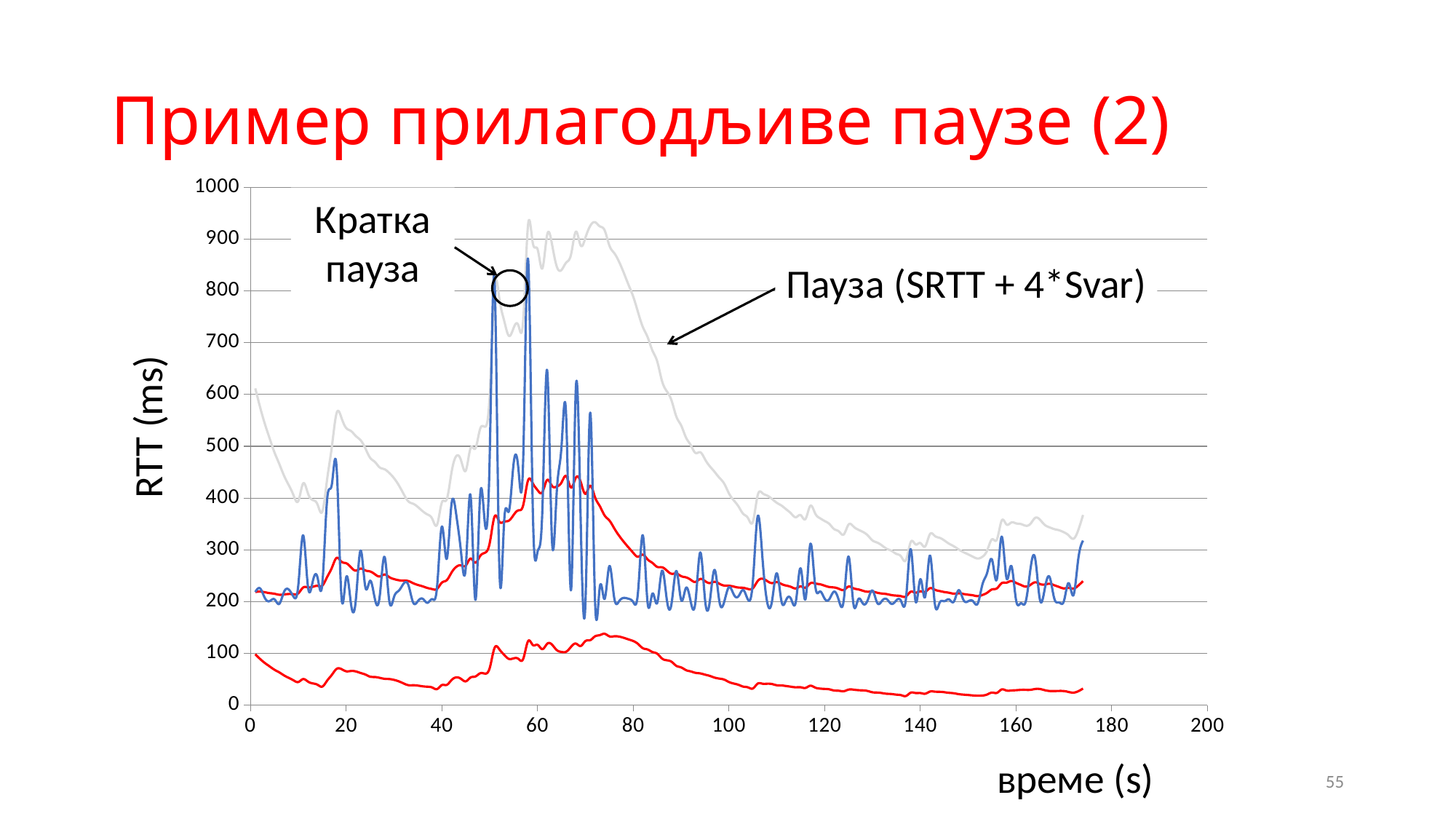
What is the label of the horizontal axis of the chart? време (s) Is the peak of the blue line near 58 s greater or less than 800? greater Is the value of the lowest red line at 80 s greater or less than 200? less Is the value of the grey line at 20 s greater or less than 500? greater What kind of chart is shown on the slide? line chart What is the highest value shown on the horizontal axis of the chart? 200 Which line reaches higher values around 60 s, the grey line or the blue line? the grey line What is the highest value shown on the vertical axis of the chart? 1000 What is the label of the vertical axis of the chart? RTT (ms) Does the grey line rise or fall between 80 s and 140 s? fall